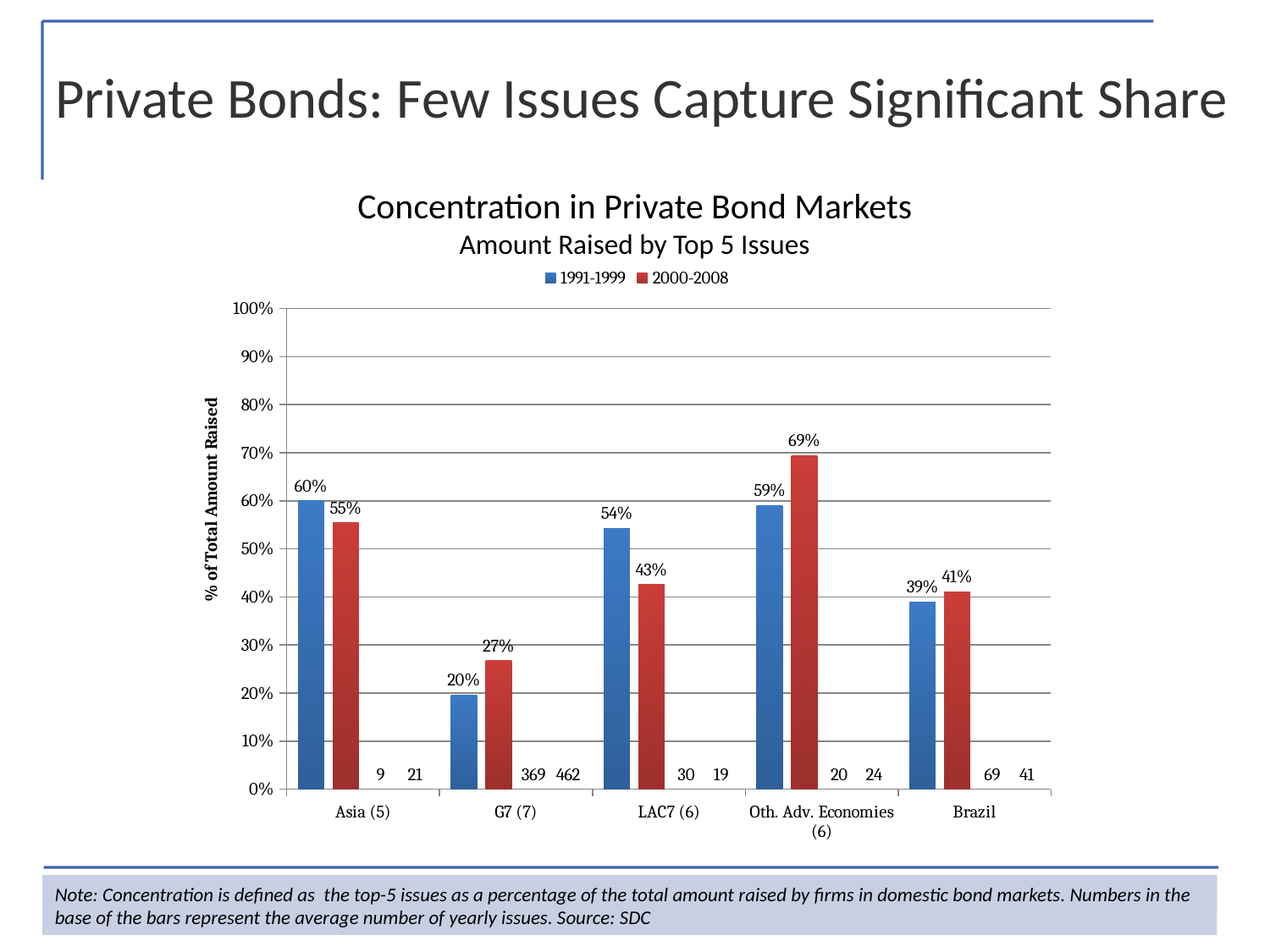
What kind of chart is shown on the slide? bar chart What is the value for LAC7 (6) in the 2000-2008 series? 43% Which is larger for LAC7 (6): the 1991-1999 value or the 2000-2008 value? 1991-1999 What is the value for Asia (5) in the 1991-1999 series? 60% What is the value for G7 (7) in the 2000-2008 series? 27% What is the difference between the 2000-2008 and 1991-1999 values for Oth. Adv. Economies (6)? 10% How many series does the legend list? 2 Which category has the highest value in the 2000-2008 series? Oth. Adv. Economies (6) What is the label of the vertical axis? % of Total Amount Raised Which category has the lowest value in the 1991-1999 series? G7 (7) How many categories are shown on the x axis? 5 Is the 1991-1999 value for Brazil greater or less than 50%? less